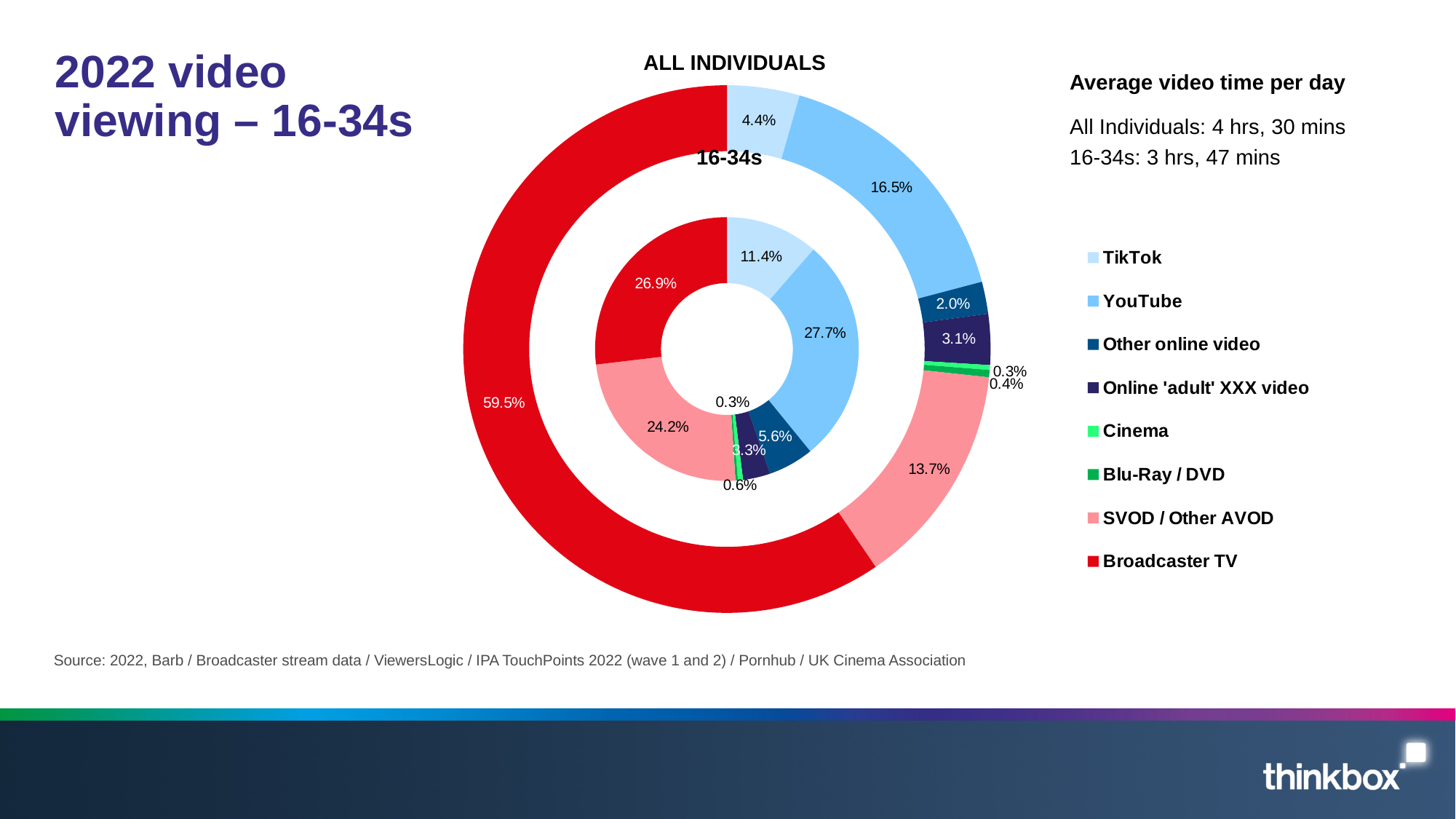
How many categories does the legend list? 8 What is the difference between the TikTok share for 16-34s and for ALL INDIVIDUALS? 7.0 percentage points In the ALL INDIVIDUALS ring, what share of video viewing is SVOD / Other AVOD? 13.7% What is the difference between the Broadcaster TV share for ALL INDIVIDUALS and for 16-34s? 32.6 percentage points In the 16-34s ring, what share of video viewing is TikTok? 11.4% According to the slide, what is the average video time per day for 16-34s? 3 hrs, 47 mins What kind of chart is shown on the slide? Doughnut chart Which category has the largest share in the ALL INDIVIDUALS ring? Broadcaster TV In the ALL INDIVIDUALS ring, what share of video viewing is Broadcaster TV? 59.5% Which is larger for 16-34s: the SVOD / Other AVOD share or the Broadcaster TV share? Broadcaster TV Which category has the largest share in the 16-34s ring? YouTube In the 16-34s ring, what share of video viewing is YouTube? 27.7%